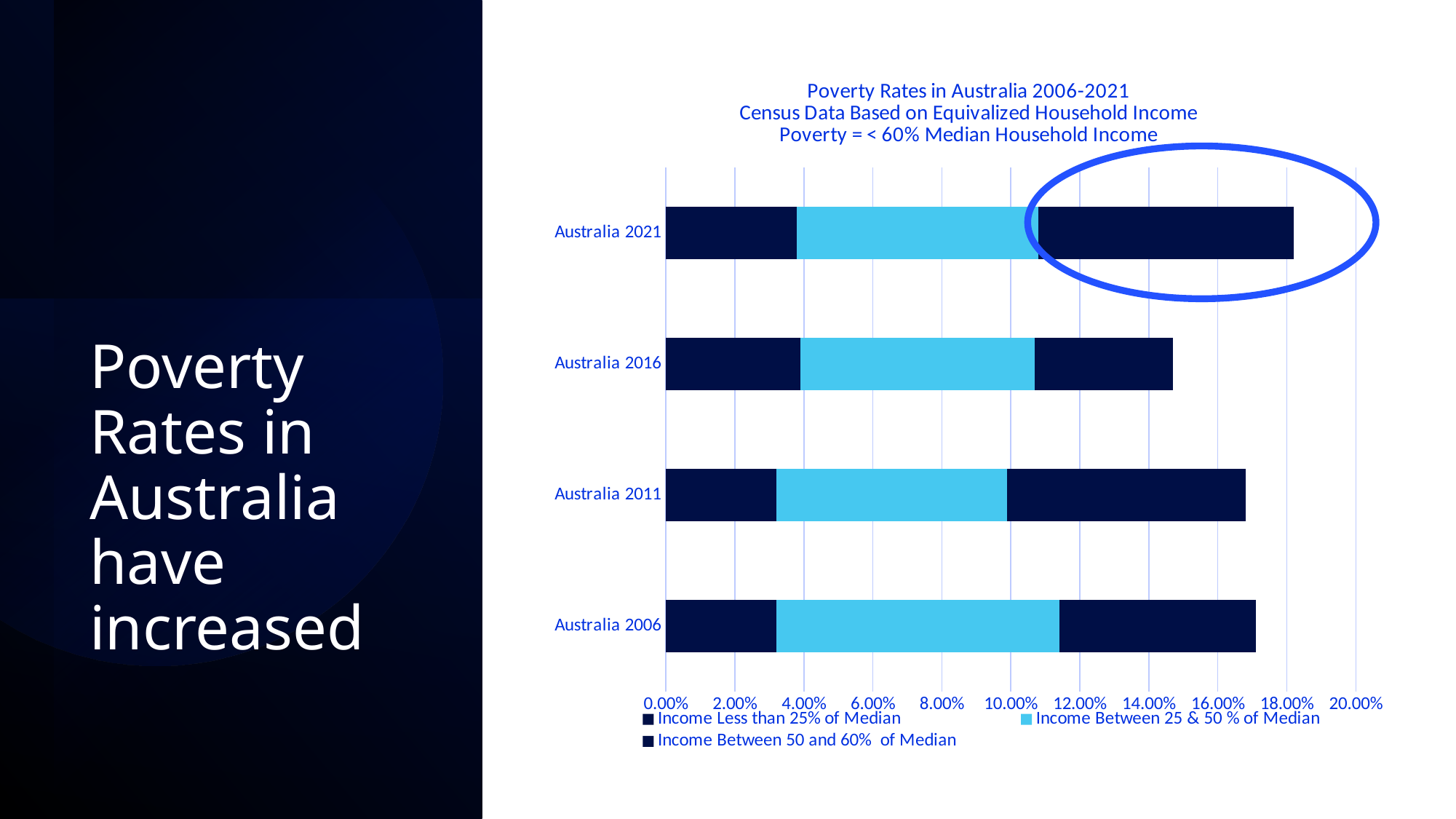
Is the total value for Australia 2021 greater or less than 16.00%? greater How many series does the legend list? 3 What kind of chart is shown on the slide? Stacked bar chart Which year has the longest total bar (highest overall poverty rate)? Australia 2021 Is the total value for Australia 2016 greater or less than 16.00%? less Which year has the shortest total bar (lowest overall poverty rate)? Australia 2016 Is the 'Income Less than 25% of Median' value for Australia 2011 greater or less than 4.00%? less Is the total bar for Australia 2021 longer or shorter than the total bar for Australia 2016? Longer How many categories (years) are plotted on the chart? 4 Which series is shown in light blue in the legend? Income Between 25 & 50 % of Median What is the first line of the chart title? Poverty Rates in Australia 2006-2021